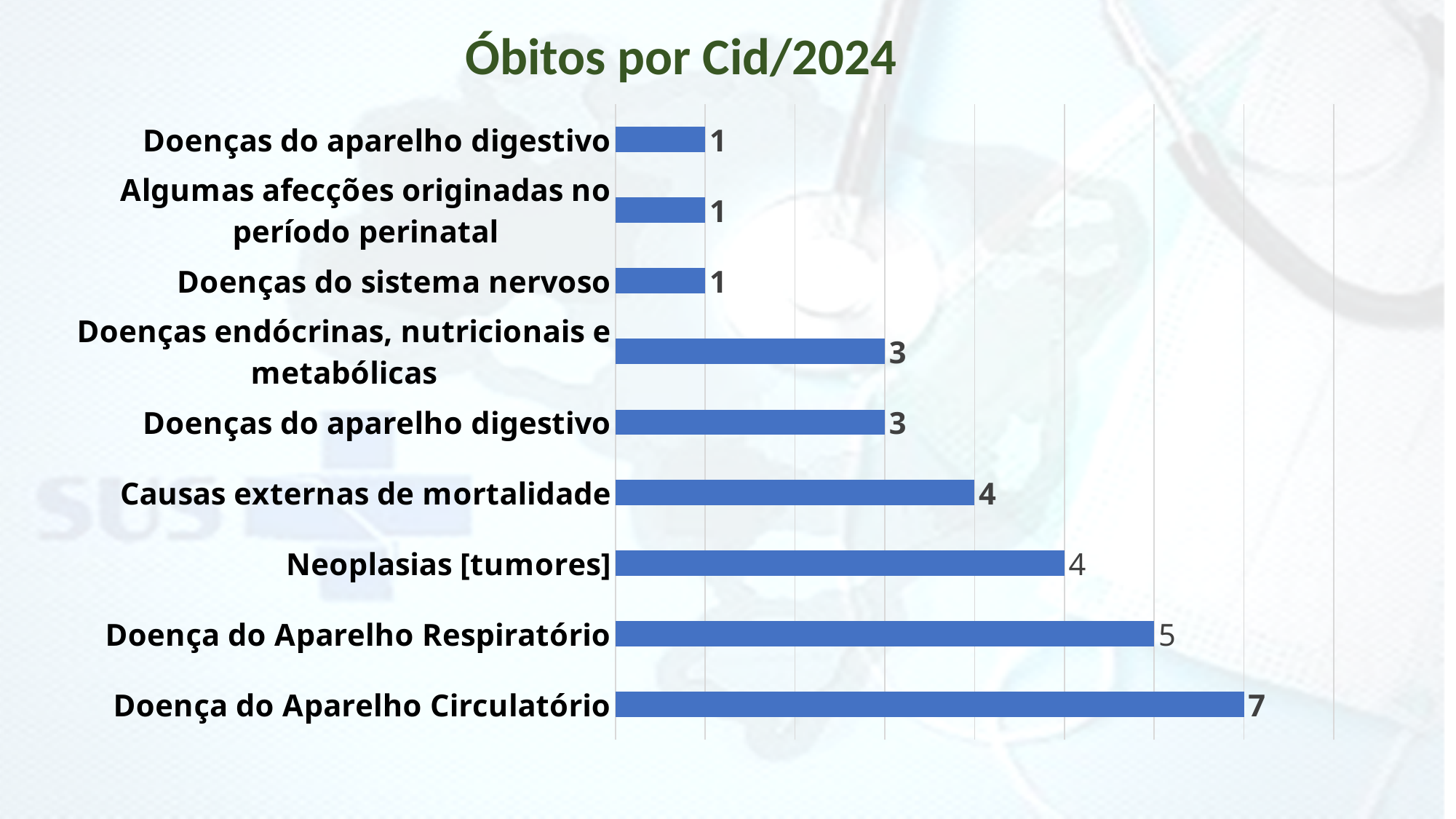
What is the title of the chart? Óbitos por Cid/2024 What is the value for Doenças do sistema nervoso? 1 What is the value for Causas externas de mortalidade? 4 What is the difference between the values for Doença do Aparelho Circulatório and Doença do Aparelho Respiratório? 2 What type of chart is shown on the slide? bar chart Which category has the highest value? Doença do Aparelho Circulatório What is the value for Doença do Aparelho Circulatório? 7 What is the value for Doença do Aparelho Respiratório? 5 What is the value for Neoplasias [tumores]? 4 What is the value for Doenças endócrinas, nutricionais e metabólicas? 3 Which is larger, the value for Doença do Aparelho Respiratório or the value for Neoplasias [tumores]? Doença do Aparelho Respiratório How many categories are plotted in the chart? 9